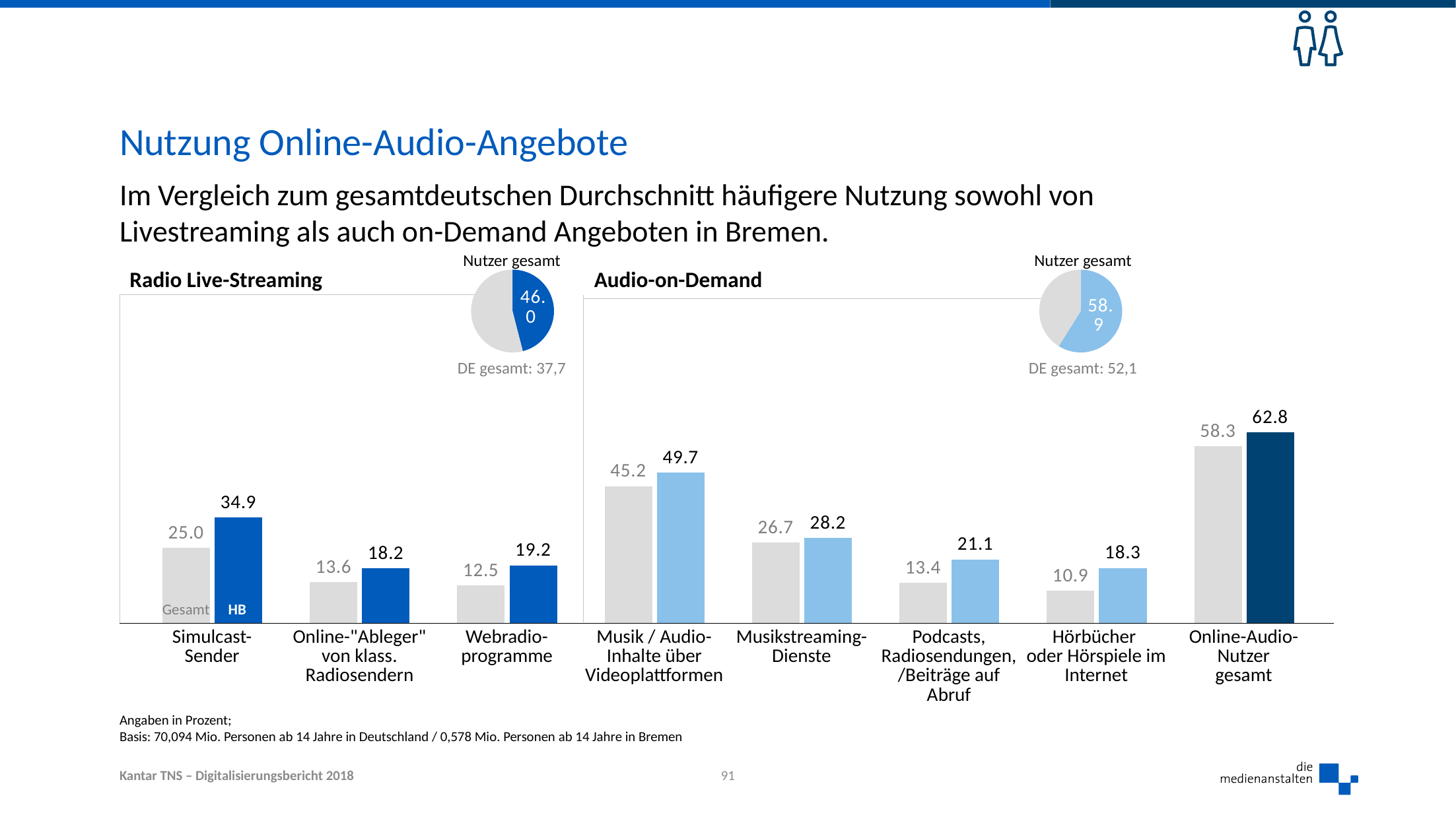
How many categories are shown in the Audio-on-Demand bar chart? 5 In the Audio-on-Demand chart, which is larger for Musikstreaming-Dienste: the Gesamt value or the HB value? HB In the Audio-on-Demand chart, what is the Gesamt value for Hörbücher oder Hörspiele im Internet? 10.9 What value is shown in the Nutzer gesamt pie chart next to the Radio Live-Streaming chart? 46.0 What type of chart is used for Radio Live-Streaming? Bar chart In the Audio-on-Demand chart, what is the HB value for Podcasts, Radiosendungen, /Beiträge auf Abruf? 21.1 In the Radio Live-Streaming chart, what is the difference between the HB and Gesamt values for Simulcast-Sender? 9.9 In the Radio Live-Streaming chart, what is the Gesamt value for Webradio-programme? 12.5 In the Radio Live-Streaming chart, which category has the lowest Gesamt value? Webradio-programme In the Radio Live-Streaming chart, what is the HB value for Simulcast-Sender? 34.9 In the Audio-on-Demand chart, what is the difference between the HB and Gesamt values for Online-Audio-Nutzer gesamt? 4.5 In the Audio-on-Demand chart, which category has the highest HB value? Online-Audio-Nutzer gesamt